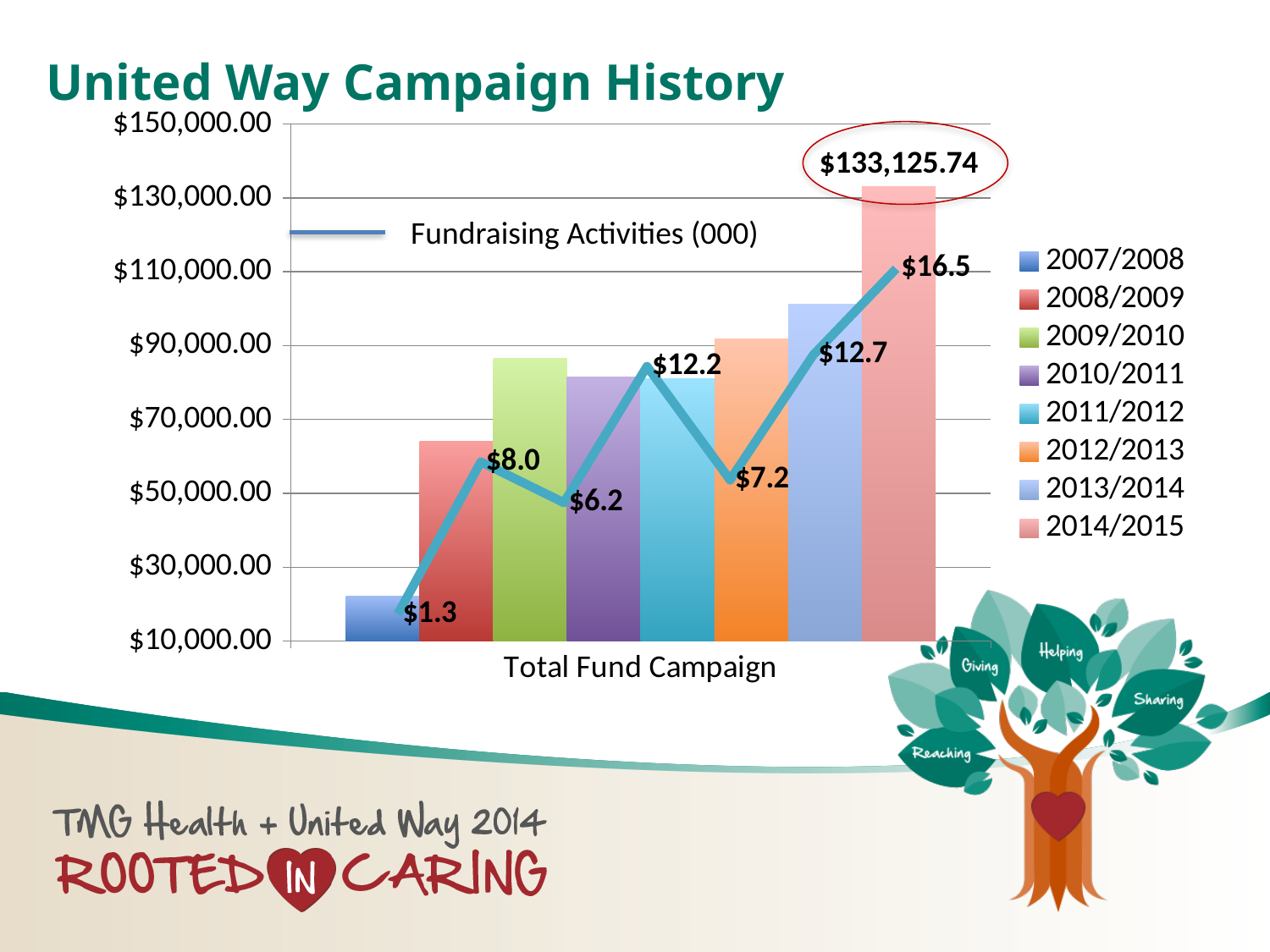
How many bars are shown in the chart? 8 Which bar is taller, 2013/2014 or 2010/2011? 2013/2014 Is the Total Fund Campaign bar for 2007/2008 greater or less than $30,000.00? less What is the title of the chart? United Way Campaign History Is the Total Fund Campaign bar for 2013/2014 greater or less than $90,000.00? greater Which year has the lowest Total Fund Campaign bar? 2007/2008 Is the Total Fund Campaign bar for 2008/2009 greater or less than $70,000.00? less What is the value printed on the 2014/2015 bar? $133,125.74 What is the difference between the last and first labelled values on the Fundraising Activities (000) line ($16.5 and $1.3)? $15.2 What is the lowest value labelled on the Fundraising Activities (000) line? $1.3 Which year has the highest Total Fund Campaign bar? 2014/2015 What is the highest value labelled on the Fundraising Activities (000) line? $16.5